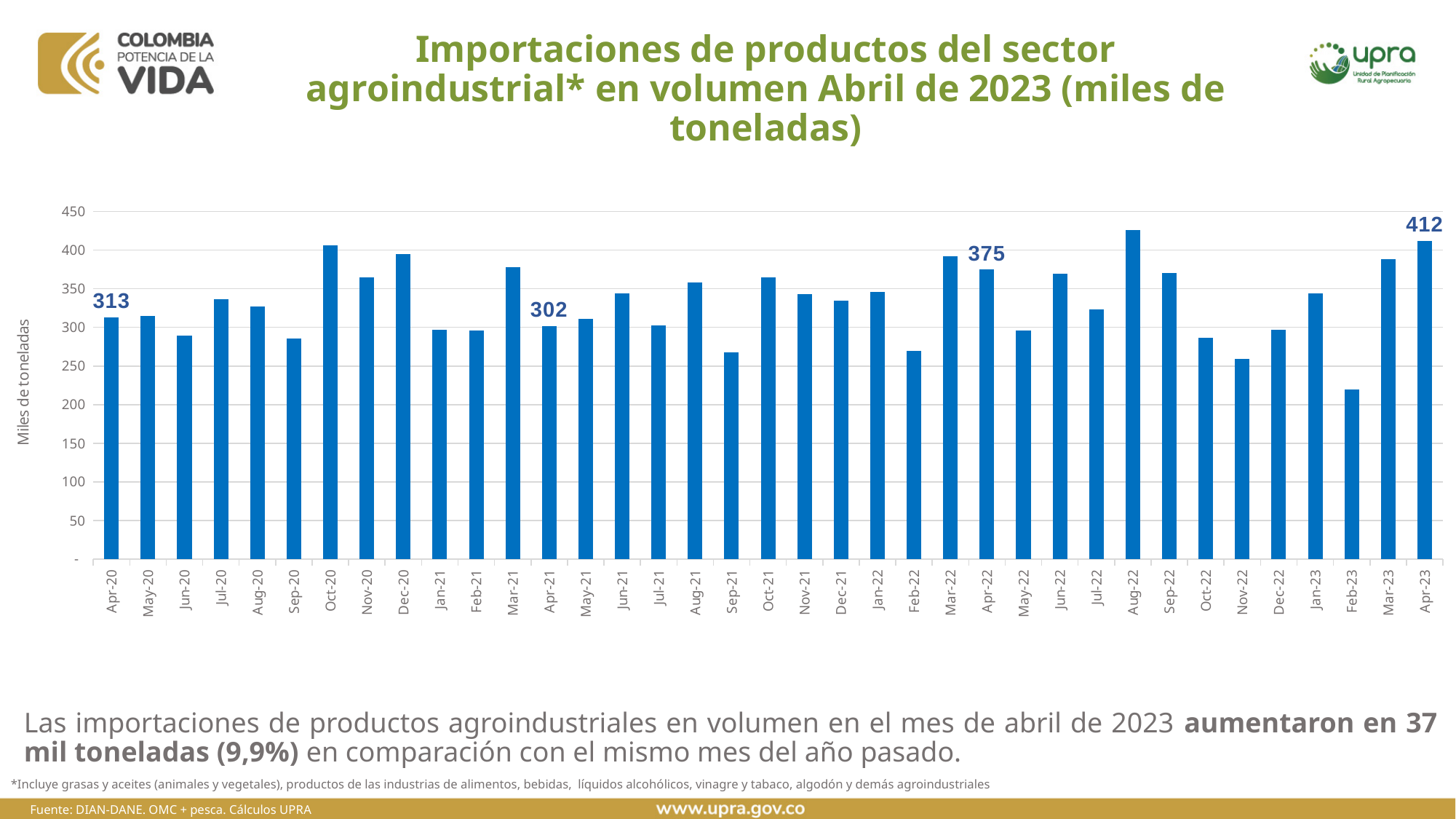
What is the value for Apr-22? 375 Is the value for Feb-23 greater or less than 250? less How many monthly bars are plotted in the chart? 37 What kind of chart is shown on the slide? bar chart What is the value for Apr-21? 302 What is the value for Apr-20? 313 What is the difference between the values for Apr-23 and Apr-22? 37 Which month has the lowest value in the chart? Feb-23 What is the value for Apr-23? 412 What is the difference between the values for Apr-22 and Apr-21? 73 Which is larger, the value for Apr-23 or the value for Apr-20? Apr-23